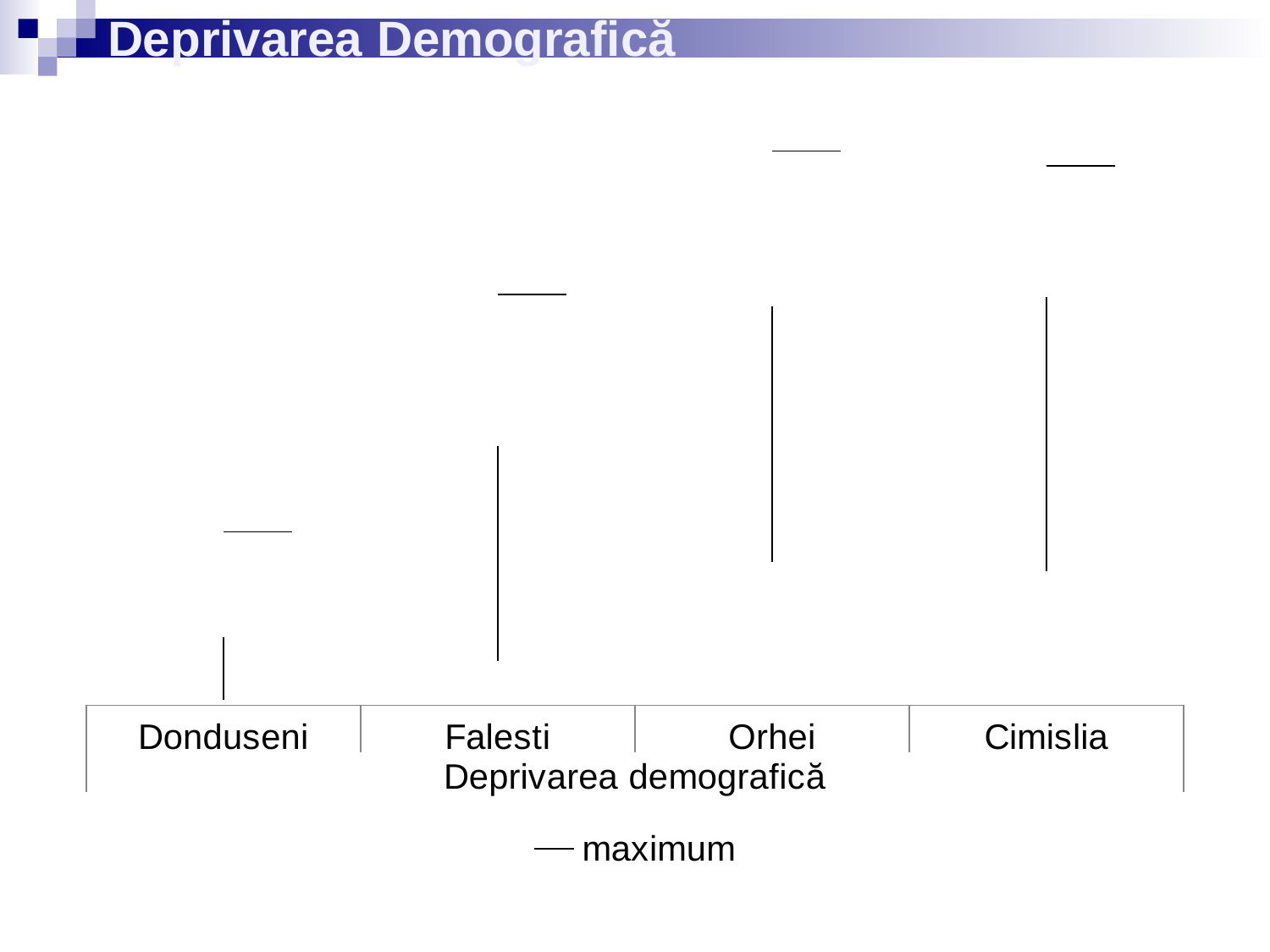
Which category is listed first (leftmost) on the x axis? Donduseni Is the 'maximum' marker for Orhei higher or lower than the one for Falesti? higher Which category has the highest 'maximum' marker on the chart? Orhei What is the name of the series listed in the chart's legend? maximum Which category is listed last (rightmost) on the x axis? Cimislia How many categories are shown along the x axis of the chart? 4 Which category has the lowest 'maximum' marker on the chart? Donduseni What label is shown beneath the category names on the x axis? Deprivarea demografică Is the 'maximum' marker for Falesti higher or lower than the one for Donduseni? higher How many series does the chart's legend list? 1 Is the 'maximum' marker for Cimislia higher or lower than the one for Donduseni? higher